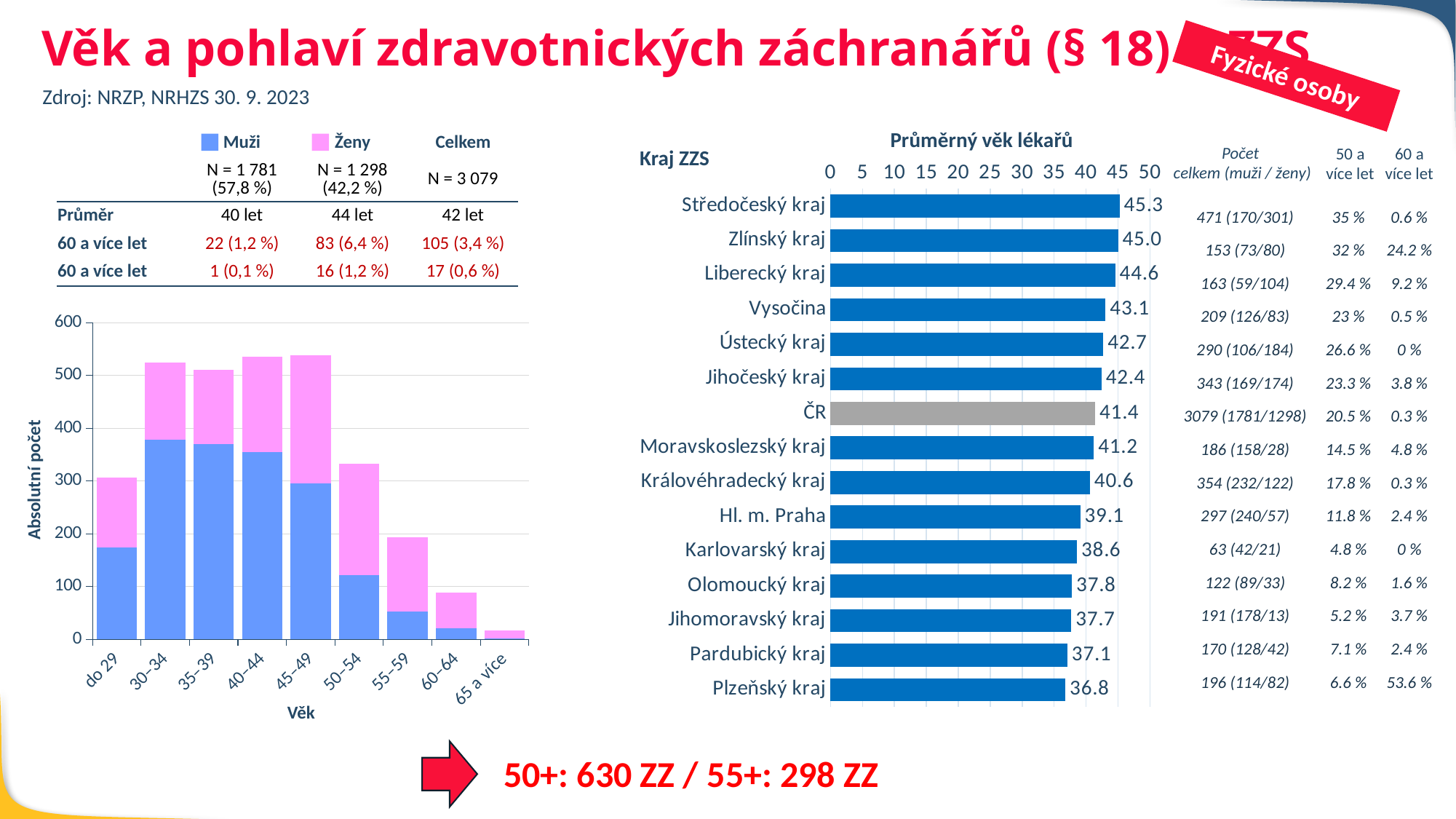
What kind of chart is the chart on the left with the 'Věk' x axis? Stacked bar chart In the chart titled 'Průměrný věk lékařů', which region has the lowest value? Plzeňský kraj In the chart titled 'Průměrný věk lékařů', which region has the highest value? Středočeský kraj In the chart on the left with the 'Věk' x axis, how many series does the legend list? 2 In the chart titled 'Průměrný věk lékařů', how many regions (bars) are shown? 15 In the chart titled 'Průměrný věk lékařů', which bar is coloured grey instead of blue? ČR In the chart titled 'Průměrný věk lékařů', which is larger: the value for Vysočina or the value for Ústecký kraj? Vysočina In the chart on the left with the 'Věk' x axis, is the total value for the 30–34 age group greater or less than 500? greater In the chart titled 'Průměrný věk lékařů', what is the value for ČR? 41.4 In the chart titled 'Průměrný věk lékařů', what is the value for Středočeský kraj? 45.3 In the chart on the left with the 'Věk' x axis, which age group has the lowest total? 65 a více In the chart titled 'Průměrný věk lékařů', what is the difference between the values for Středočeský kraj and Plzeňský kraj? 8.5